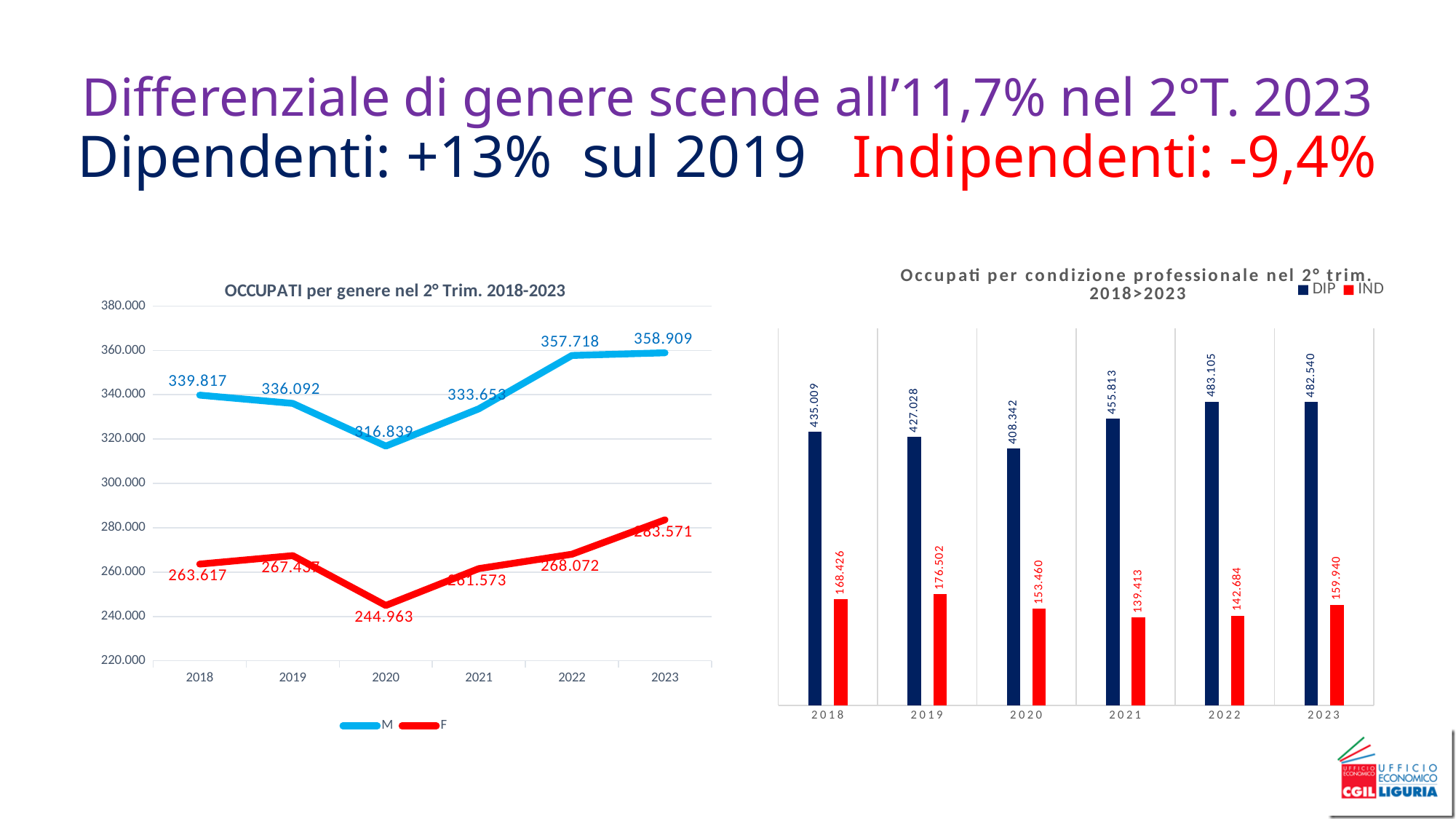
In the left chart 'OCCUPATI per genere nel 2° Trim. 2018-2023', what is the value for F in 2020? 244.963 In the right chart 'Occupati per condizione professionale nel 2° trim. 2018>2023', what is the DIP value for 2021? 455.813 In the right chart 'Occupati per condizione professionale nel 2° trim. 2018>2023', which year has the lowest IND value? 2021 In the right chart 'Occupati per condizione professionale nel 2° trim. 2018>2023', which year has the lowest DIP value? 2020 In the right chart 'Occupati per condizione professionale nel 2° trim. 2018>2023', what is the difference between the DIP values in 2022 and 2023? 565 In the right chart 'Occupati per condizione professionale nel 2° trim. 2018>2023', how many years are shown on the x axis? 6 In the left chart 'OCCUPATI per genere nel 2° Trim. 2018-2023', which year has the highest value for M? 2023 In the left chart 'OCCUPATI per genere nel 2° Trim. 2018-2023', what is the difference between the M values in 2018 and 2020? 22.978 In the right chart 'Occupati per condizione professionale nel 2° trim. 2018>2023', what is the IND value for 2019? 176.502 In the left chart 'OCCUPATI per genere nel 2° Trim. 2018-2023', what type of chart is shown? line chart In the left chart 'OCCUPATI per genere nel 2° Trim. 2018-2023', how many series does the legend list? 2 In the left chart 'OCCUPATI per genere nel 2° Trim. 2018-2023', what is the value for M in 2020? 316.839